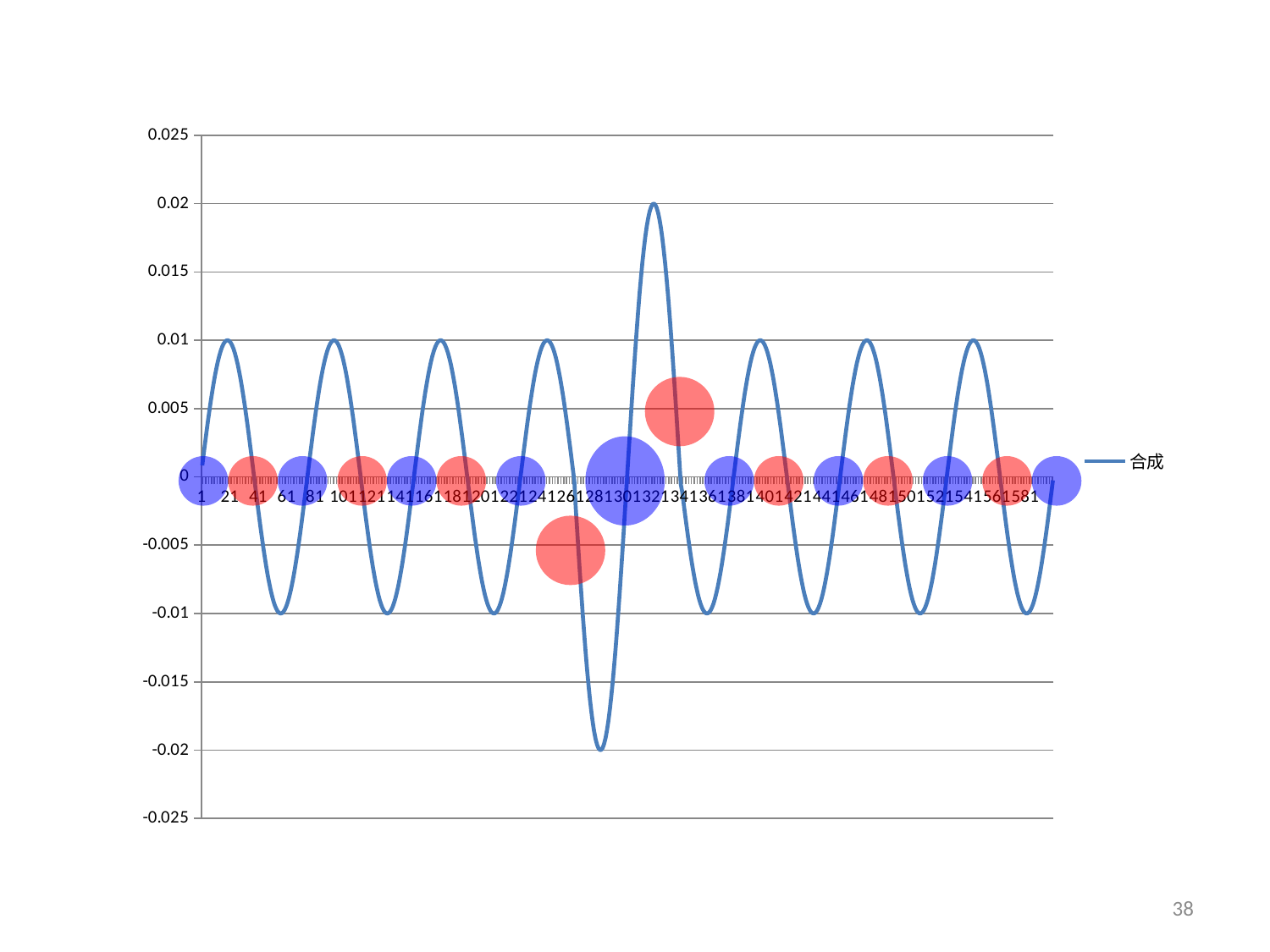
What value do the regular (smaller) troughs of the 合成 line reach, such as the one near x = 61? -0.01 What is the highest value reached by the 合成 line? 0.02 What is the lowest value reached by the 合成 line? -0.02 Is the trough of the 合成 line near x = 301 greater or less than -0.015? less What is the maximum value shown on the y-axis? 0.025 How many series does the legend list? 1 Is the peak of the 合成 line near x = 321 greater or less than 0.015? greater What is the last label shown on the x-axis? 581 What is the name of the series shown in the legend? 合成 What kind of chart is shown on the slide? line chart Which is larger: the peak of the 合成 line near x = 321 or the peak near x = 421? the peak near x = 321 What value do the regular (smaller) peaks of the 合成 line reach, such as the one near x = 21? 0.01